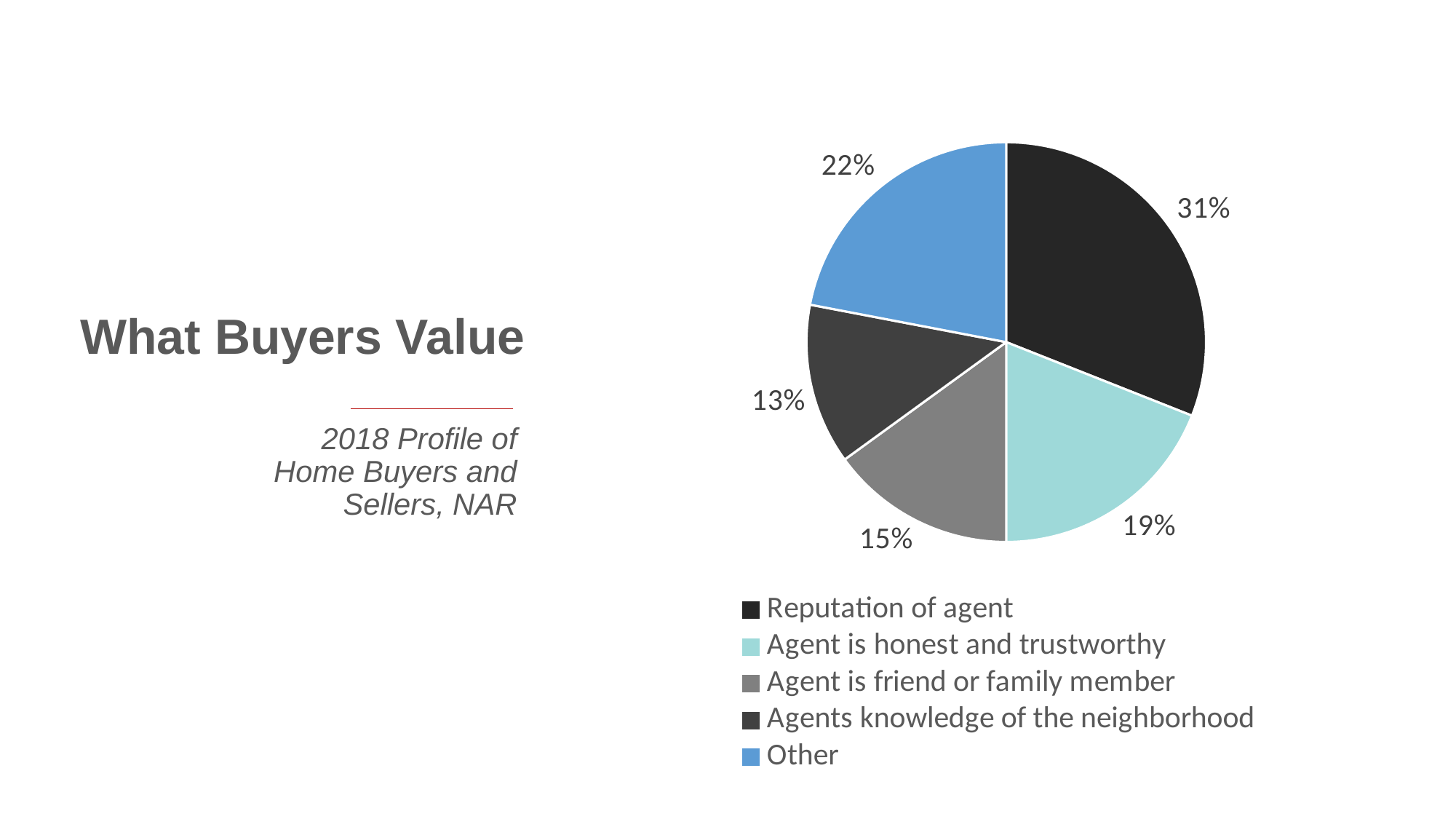
Which is larger: the slice for Other or the slice for Agent is honest and trustworthy? Other What kind of chart is shown on the slide? pie chart What share of the pie is labelled for Agents knowledge of the neighborhood? 13% What share of the pie is labelled for Agent is honest and trustworthy? 19% What is the title of the slide containing the chart? What Buyers Value Which category has the smallest slice of the pie? Agents knowledge of the neighborhood Which category has the largest slice of the pie? Reputation of agent How many slices does the pie chart have? 5 What share of the pie is labelled for Agent is friend or family member? 15% What share of the pie is labelled for Reputation of agent? 31% What is the difference in percentage points between Reputation of agent and Other? 9 What share of the pie is labelled for Other? 22%